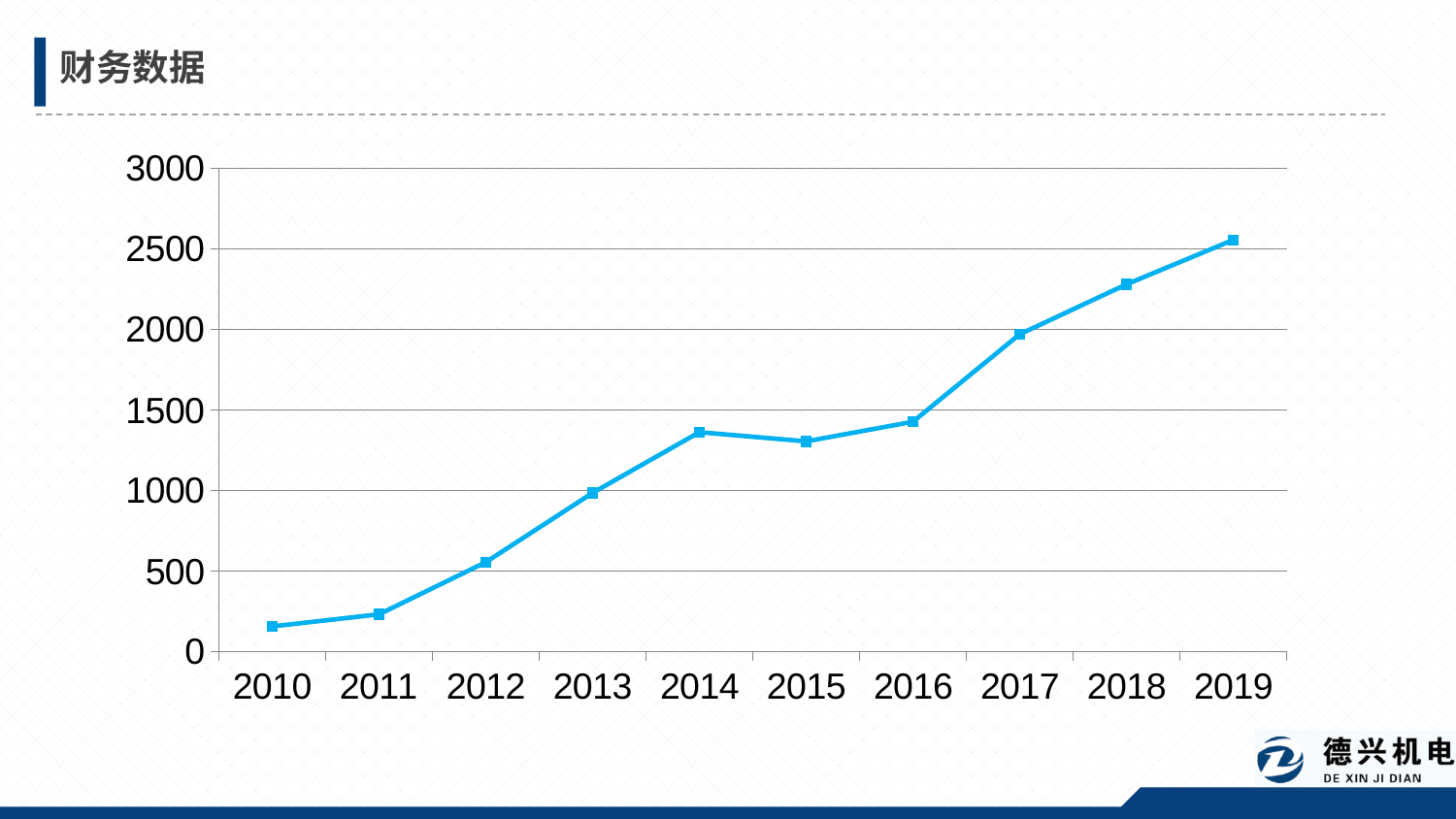
Which is larger, the value for 2017 or the value for 2016? 2017 Which year has the highest value? 2019 How many years are plotted along the x axis? 10 Do the values generally rise or fall from 2010 to 2019? rise Is the value for 2018 greater or less than 2000? greater What is the title of the slide containing the chart? 财务数据 Is the value for 2014 greater or less than 1000? greater Which year has the lowest value? 2010 What kind of chart is shown on the slide? line chart Is the value for 2019 greater or less than 2000? greater